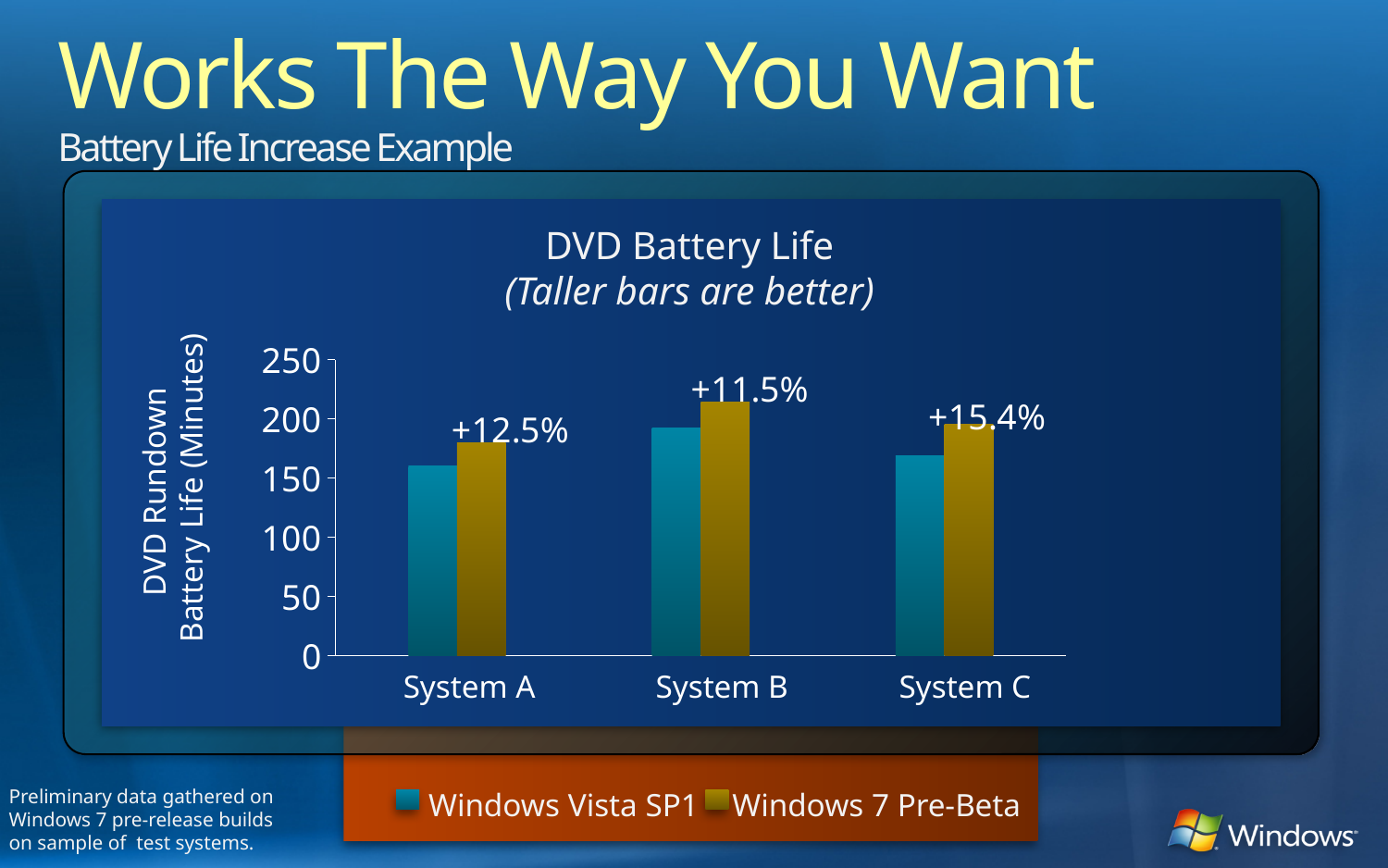
What is the title of the chart? DVD Battery Life How many series does the legend of the DVD Battery Life chart list? 2 Which system shows the smallest labelled percentage increase in battery life? System B What kind of chart is shown on the slide? bar chart How many systems are shown on the x axis of the DVD Battery Life chart? 3 What percentage increase is labelled above the System B bars? +11.5% What percentage increase is labelled above the System A bars? +12.5% Which system shows the largest labelled percentage increase in battery life? System C Is the Windows Vista SP1 value for System A greater or less than 200? less What percentage increase is labelled above the System C bars? +15.4% Which system has the tallest Windows 7 Pre-Beta bar? System B Is the Windows 7 Pre-Beta value for System B greater or less than 200? greater